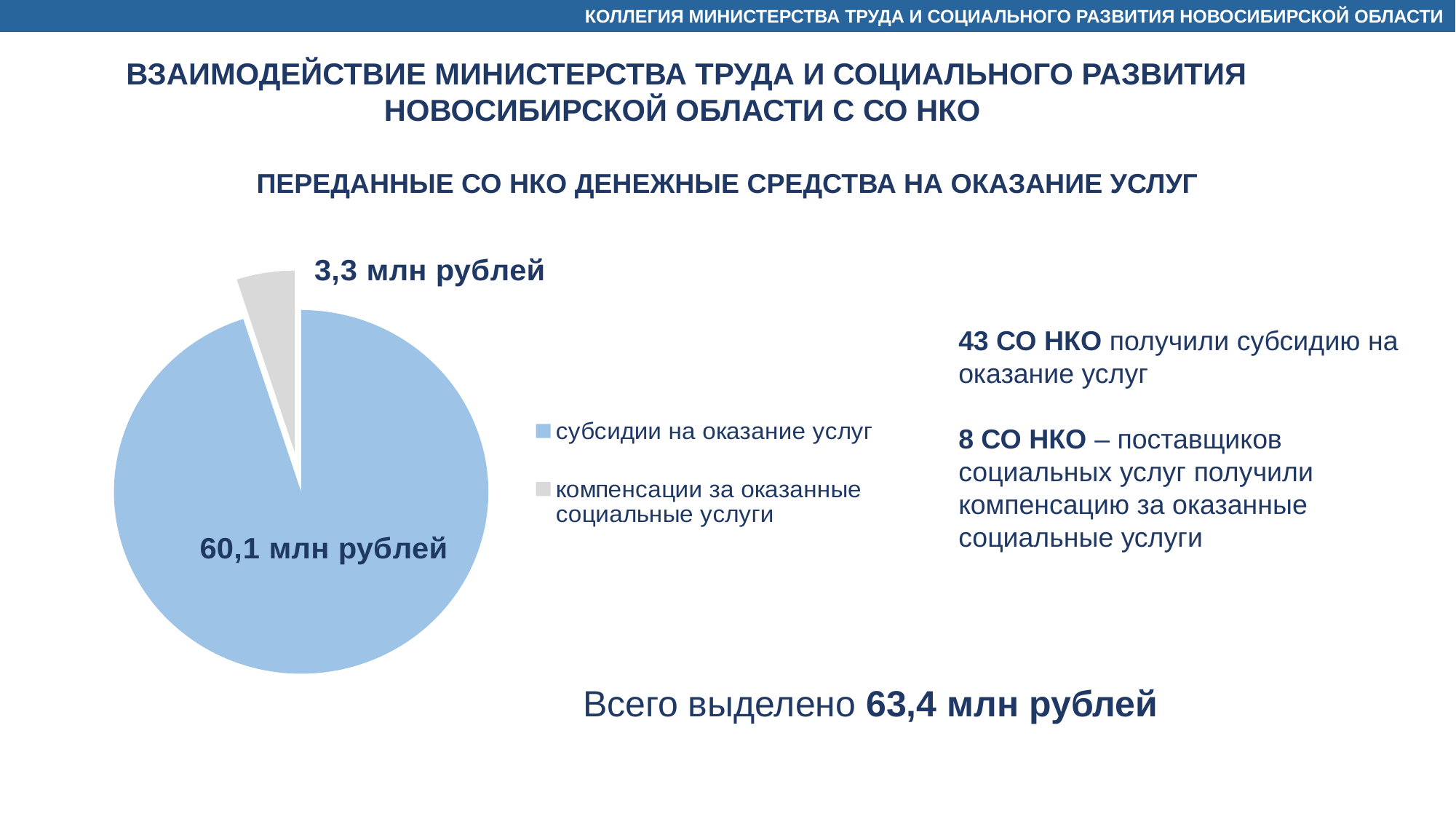
Какой тип диаграммы показан на слайде? Круговая диаграмма Какое значение указано для сектора «субсидии на оказание услуг»? 60,1 млн рублей Какова общая сумма выделенных средств, указанная на слайде? 63,4 млн рублей Сколько категорий (секторов) показано на круговой диаграмме? 2 Какую долю от общей суммы 63,4 млн рублей составляют компенсации за оказанные социальные услуги (3,3 млн рублей)? 5,2% Какая категория на диаграмме имеет наибольшее значение? субсидии на оказание услуг Какая категория на диаграмме имеет наименьшее значение? компенсации за оказанные социальные услуги Что больше: субсидии на оказание услуг или компенсации за оказанные социальные услуги? субсидии на оказание услуг Каким цветом на диаграмме обозначен сектор «субсидии на оказание услуг»? Голубым Как называется диаграмма на слайде? ПЕРЕДАННЫЕ СО НКО ДЕНЕЖНЫЕ СРЕДСТВА НА ОКАЗАНИЕ УСЛУГ Какое значение указано для сектора «компенсации за оказанные социальные услуги»? 3,3 млн рублей На сколько млн рублей субсидии на оказание услуг превышают компенсации за оказанные социальные услуги? 56,8 млн рублей